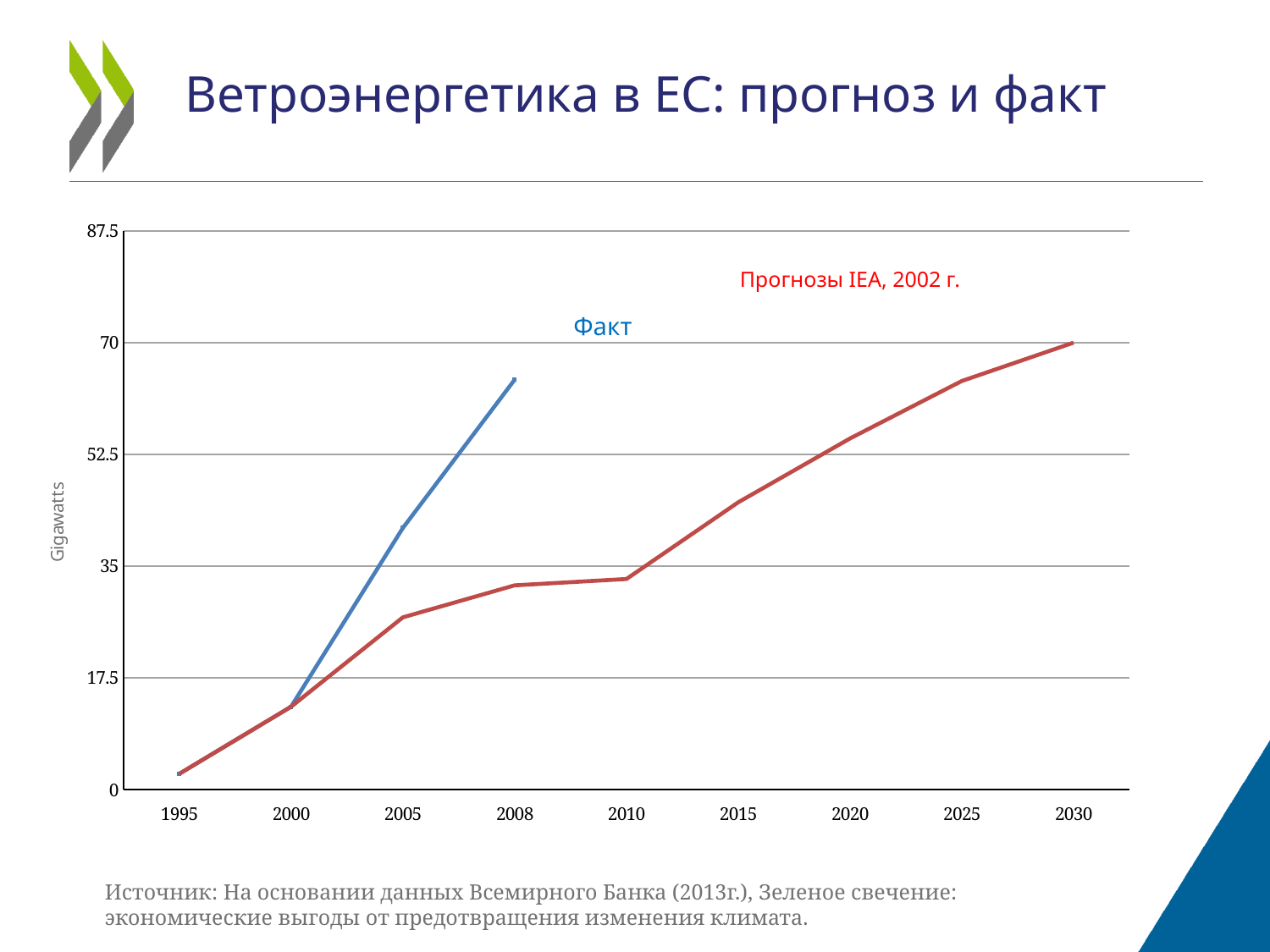
What kind of chart is shown on the slide? line chart How many year labels are shown on the x axis? 9 Is the value of the Прогнозы IEA, 2002 г. line in 2005 greater or less than 35? less Is the value of the Прогнозы IEA, 2002 г. line in 2025 greater or less than 70? less Is the value of the Прогнозы IEA, 2002 г. line in 2015 greater or less than 35? greater In 2008, which line is higher: Факт or Прогнозы IEA, 2002 г.? Факт What is the label of the y axis? Gigawatts How many series are plotted on the chart? 2 What is the label of the red line? Прогнозы IEA, 2002 г. Does the Прогнозы IEA, 2002 г. line rise or fall from 1995 to 2030? rise